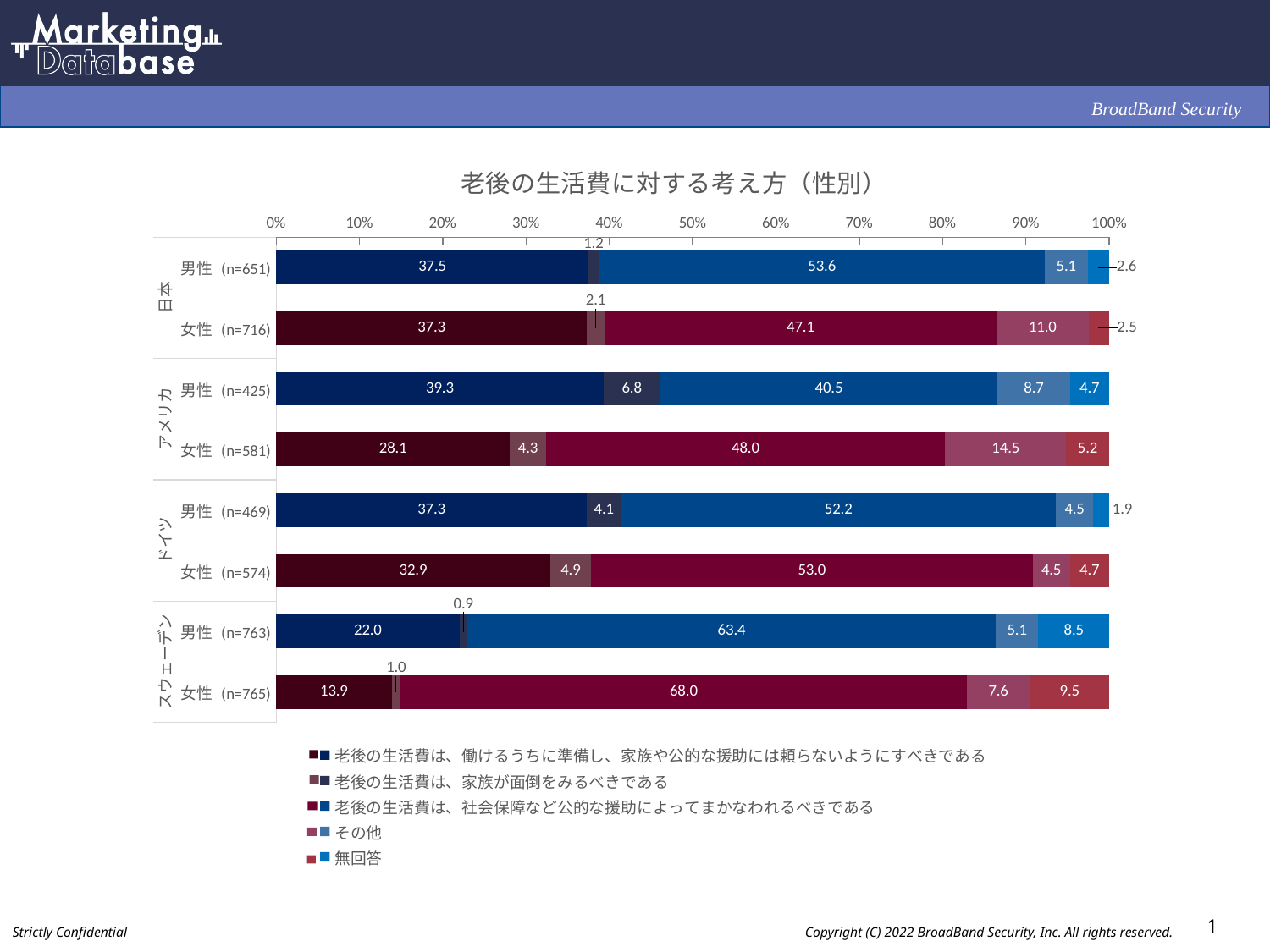
Which group has the lowest value for 「老後の生活費は、働けるうちに準備し、家族や公的な援助には頼らないようにすべきである」? スウェーデン 女性 (n=765) What is the value of 「老後の生活費は、働けるうちに準備し、家族や公的な援助には頼らないようにすべきである」 for アメリカ 男性 (n=425)? 39.3 What is the value of 「その他」 for アメリカ 女性 (n=581)? 14.5 What is the title of the chart? 老後の生活費に対する考え方（性別） Which has a larger value for 「老後の生活費は、家族が面倒をみるべきである」: アメリカ 男性 (n=425) or ドイツ 男性 (n=469)? アメリカ 男性 (n=425) Which group has the highest value for 「老後の生活費は、社会保障など公的な援助によってまかなわれるべきである」? スウェーデン 女性 (n=765) What is the difference between the 「老後の生活費は、社会保障など公的な援助によってまかなわれるべきである」 values for スウェーデン 男性 (n=763) and 日本 男性 (n=651)? 9.8 What is the value of 「老後の生活費は、社会保障など公的な援助によってまかなわれるべきである」 for スウェーデン 女性 (n=765)? 68.0 How many bars (gender groups) are plotted in the chart? 8 How many series does the legend list? 5 What type of chart is shown on the slide? Stacked bar chart What is the value of 「老後の生活費は、家族が面倒をみるべきである」 for 日本 女性 (n=716)? 2.1